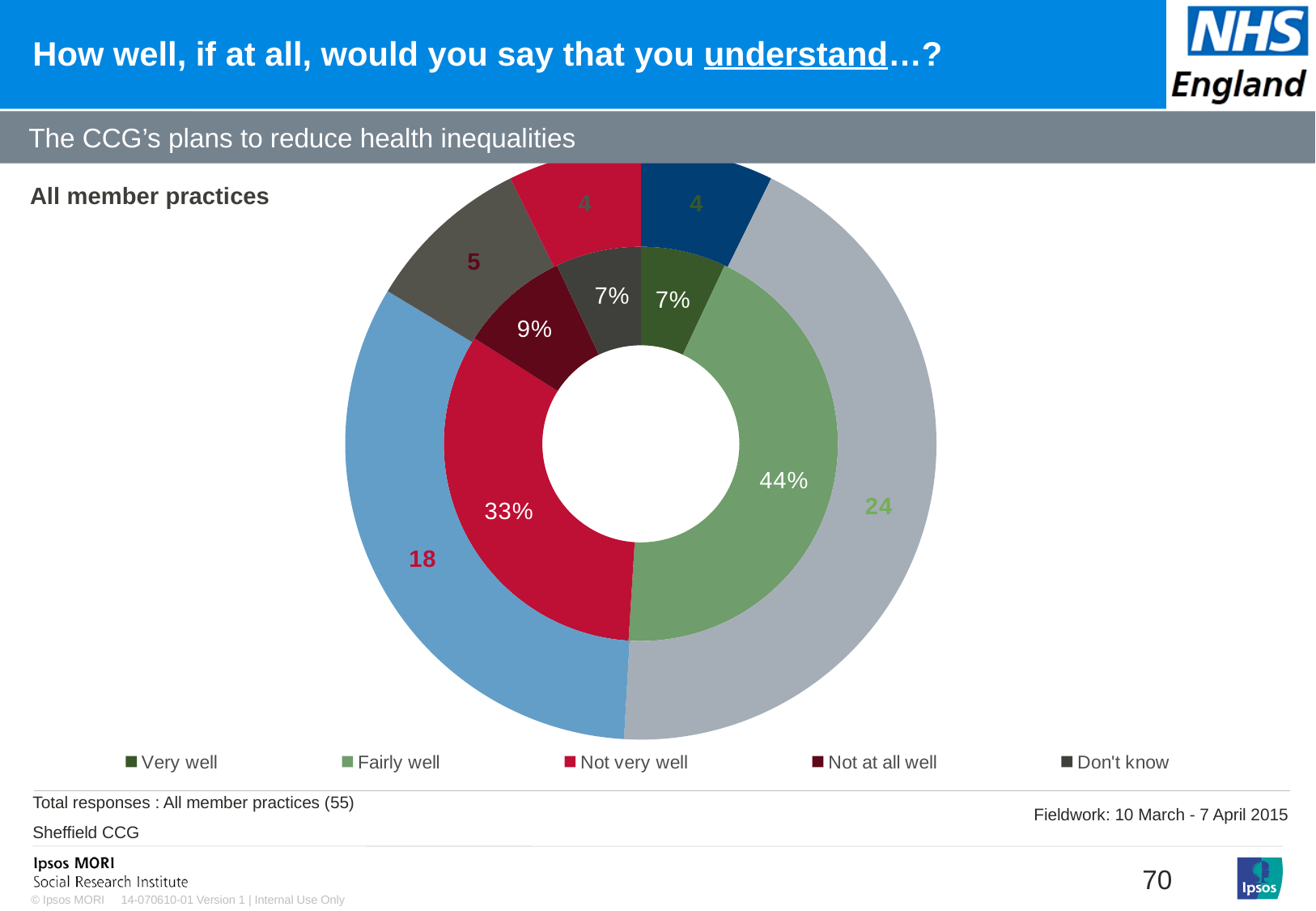
Which is larger, the share for 'Not very well' or the share for 'Not at all well'? Not very well How many response categories does the legend list? 5 Which response category has the largest share of the doughnut? Fairly well What is the difference in percentage points between 'Fairly well' and 'Not very well'? 11 What colour represents 'Not very well' in the legend? Red What percentage of respondents said they understand the CCG's plans to reduce health inequalities 'Fairly well'? 44% What kind of chart is shown on the slide? Doughnut chart What percentage of respondents answered 'Not at all well'? 9% What percentage of respondents answered 'Not very well'? 33% What is the total number of responses shown for all member practices? 55 What percentage of respondents answered 'Very well'? 7% How many respondents does the outer ring show for the largest segment? 24